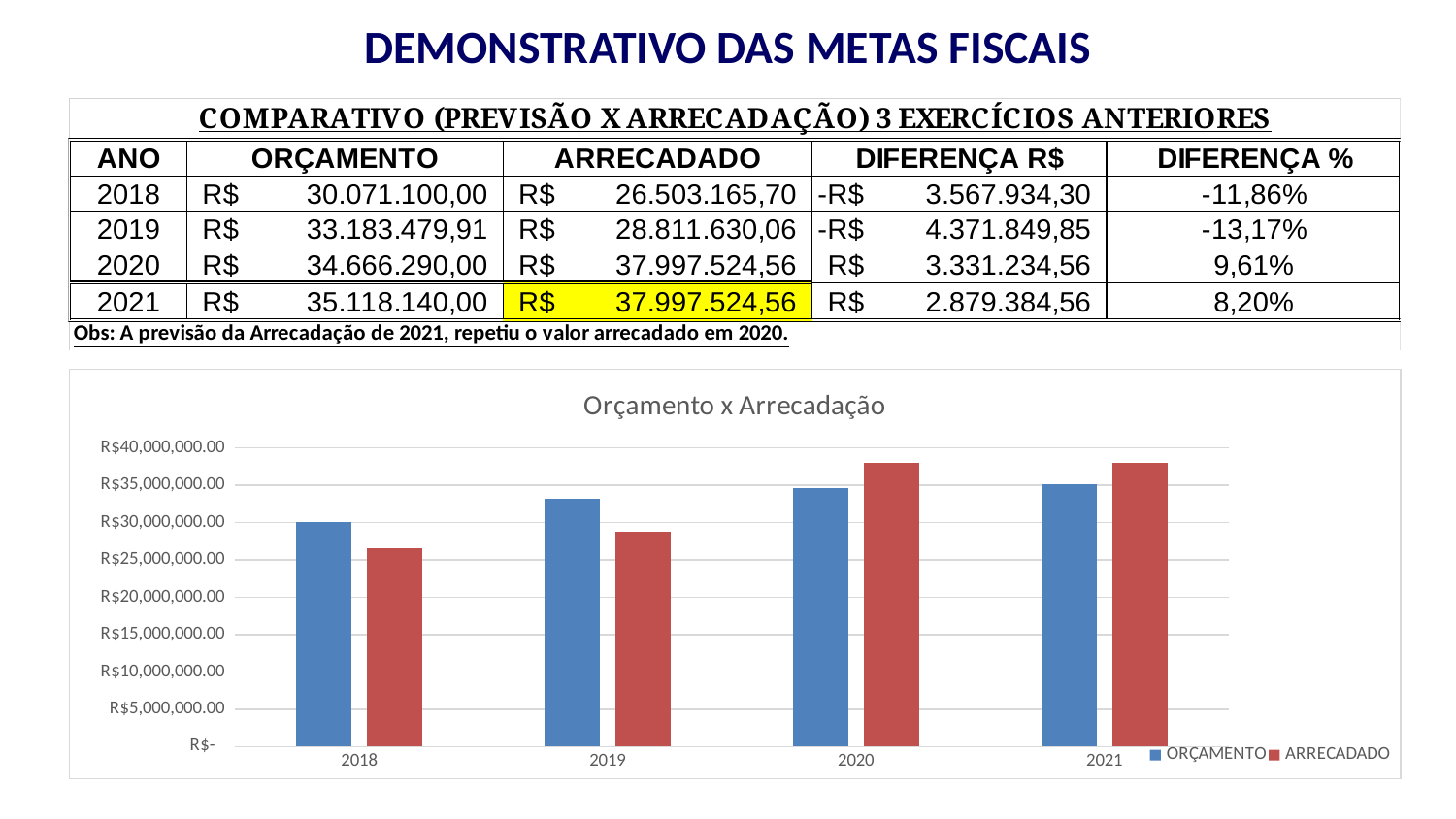
In the chart, is the ARRECADADO value for 2020 greater or less than R$35,000,000.00? greater What kind of chart is shown on the slide? bar chart In the chart, is the ARRECADADO value for 2018 greater or less than R$25,000,000.00? greater In the chart, is the ORÇAMENTO value for 2019 greater or less than R$35,000,000.00? less Which series is shown in red in the chart? ARRECADADO What is the title of the chart? Orçamento x Arrecadação In the chart, which is larger for 2018, ORÇAMENTO or ARRECADADO? ORÇAMENTO How many series does the chart legend list? 2 How many years are shown on the x axis of the chart? 4 In the chart, which is larger for 2020, ORÇAMENTO or ARRECADADO? ARRECADADO In the chart, which year has the lowest ARRECADADO value? 2018